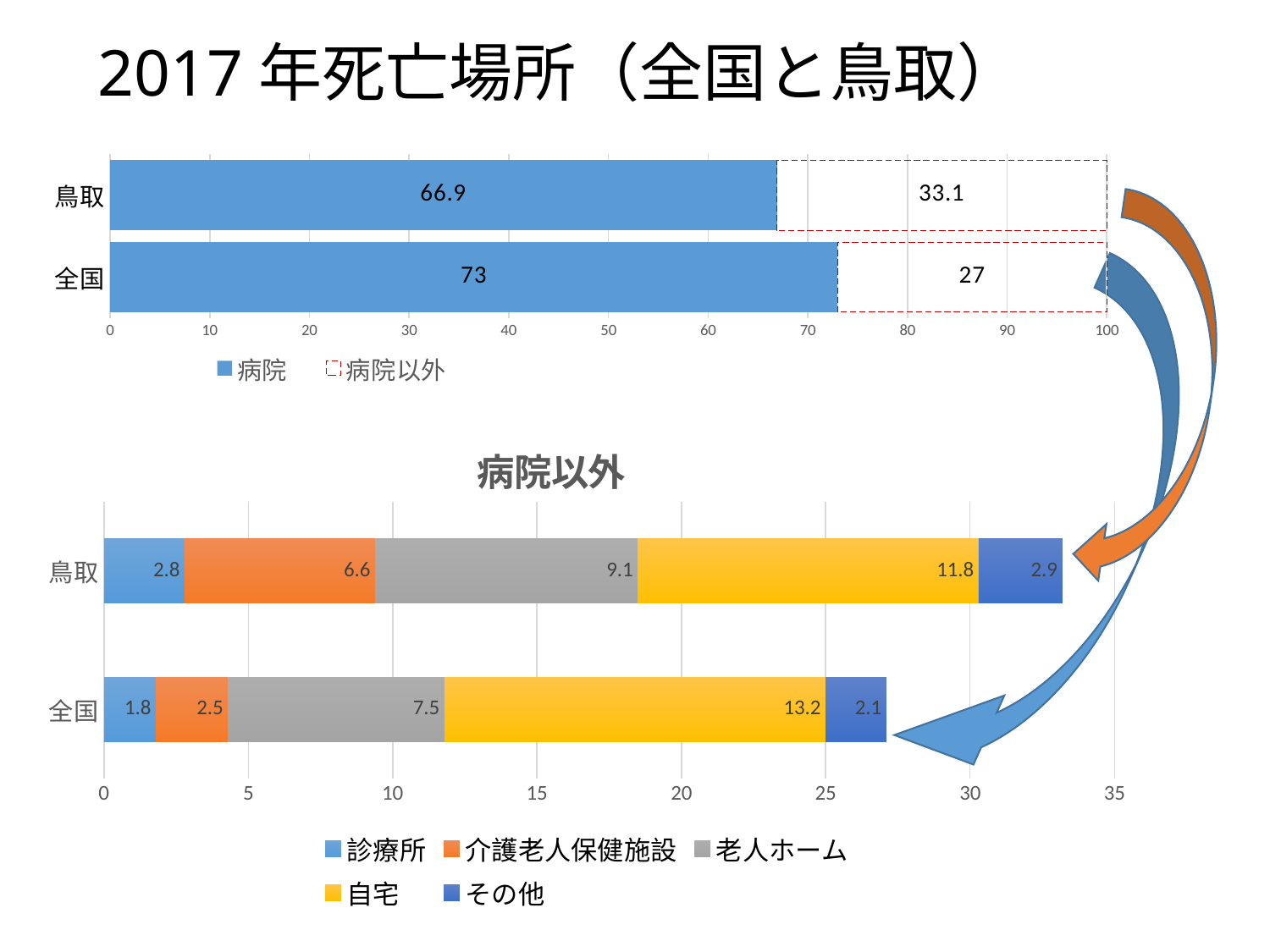
In the top chart, what is the difference between the 病院以外 values for 鳥取 and 全国? 6.1 In the top chart, what is the value of 病院 for 鳥取? 66.9 In the top chart, what is the value of 病院以外 for 全国? 27 In the bottom chart titled 病院以外, what is the value of 自宅 for 全国? 13.2 In the top chart, how many series does the legend list? 2 In the bottom chart titled 病院以外, what is the value of 老人ホーム for 鳥取? 9.1 In the bottom chart titled 病院以外, what is the difference between the 介護老人保健施設 values for 鳥取 and 全国? 4.1 What kind of chart is the bottom chart titled 病院以外? Stacked bar chart In the bottom chart titled 病院以外, which category has the smallest value for 全国? 診療所 In the top chart, which region has the higher 病院 value, 鳥取 or 全国? 全国 In the bottom chart titled 病院以外, how many series does the legend list? 5 In the bottom chart titled 病院以外, which category has the largest value for 鳥取? 自宅